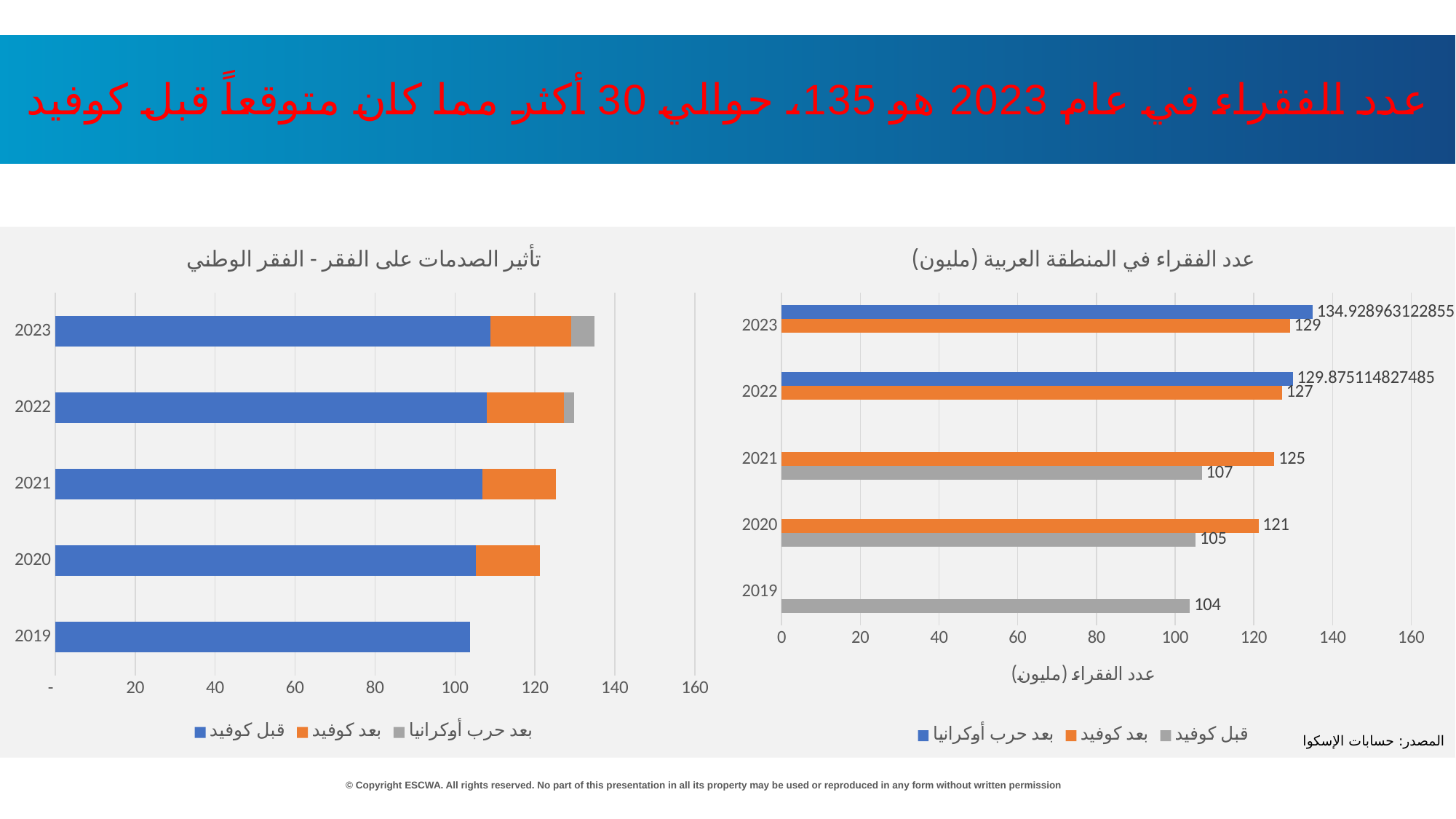
In the chart titled 'عدد الفقراء في المنطقة العربية (مليون)', which year has the highest 'بعد كوفيد' value? 2023 In the chart titled 'عدد الفقراء في المنطقة العربية (مليون)', which is larger for 2020: the 'بعد كوفيد' value or the 'قبل كوفيد' value? بعد كوفيد In the chart titled 'تأثير الصدمات على الفقر - الفقر الوطني', is the total bar length for 2023 greater or less than 120? greater In the chart titled 'عدد الفقراء في المنطقة العربية (مليون)', do the 'بعد كوفيد' values rise or fall from 2020 to 2023? rise In the chart titled 'عدد الفقراء في المنطقة العربية (مليون)', what is the value of the 'قبل كوفيد' series for 2019? 104 How many years are shown on the chart titled 'تأثير الصدمات على الفقر - الفقر الوطني'? 5 In the chart titled 'عدد الفقراء في المنطقة العربية (مليون)', what is the difference between the 'بعد كوفيد' and 'قبل كوفيد' values for 2021? 18 How many series does the legend of the chart titled 'عدد الفقراء في المنطقة العربية (مليون)' list? 3 In the chart titled 'عدد الفقراء في المنطقة العربية (مليون)', what is the difference between the 'بعد كوفيد' values for 2023 and 2022? 2 What kind of chart is the chart titled 'تأثير الصدمات على الفقر - الفقر الوطني'? stacked bar chart In the chart titled 'عدد الفقراء في المنطقة العربية (مليون)', what is the value of the 'بعد حرب أوكرانيا' series for 2023? 134.928963122855 In the chart titled 'عدد الفقراء في المنطقة العربية (مليون)', what is the value of the 'بعد كوفيد' series for 2021? 125